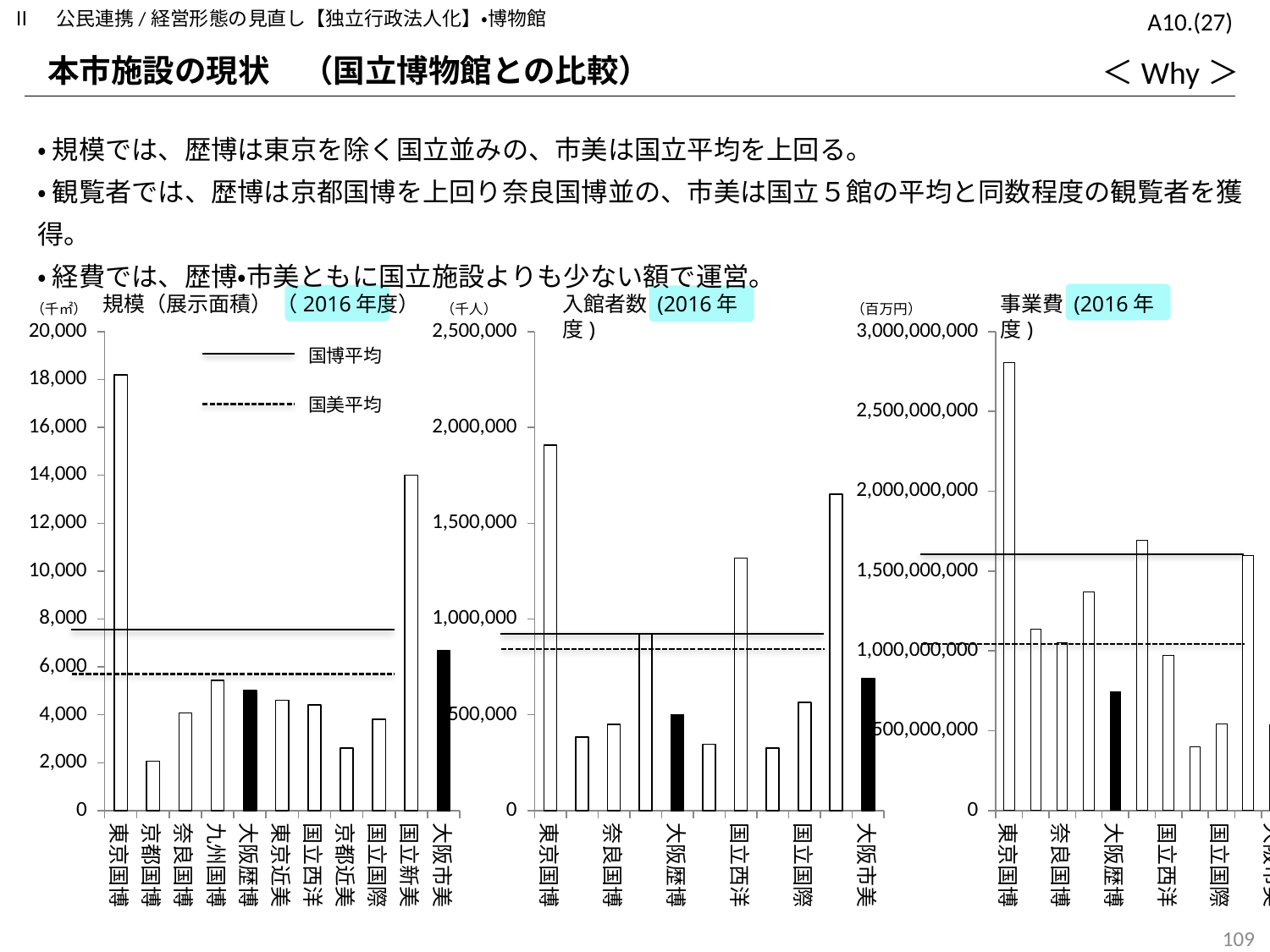
In the 規模（展示面積） chart, is the value for 京都国博 greater or less than 4,000? less In the 入館者数 chart, is the value for 大阪市美 greater or less than 1,000,000? less In the 規模（展示面積） chart, which category has the lowest value? 京都国博 In the 事業費 chart, which is larger, 東京国博 or 大阪歴博? 東京国博 In the 事業費 chart, is the value for 大阪歴博 greater or less than 500,000,000? greater In the 規模（展示面積） chart, which category has the highest value? 東京国博 In the 入館者数 chart, which category has the highest value? 東京国博 How many categories are shown on the x axis of the 規模（展示面積） chart? 11 What kind of chart is the 規模（展示面積） chart on the left? bar chart In the 規模（展示面積） chart, which is larger, 東京国博 or 国立新美? 東京国博 How many entries does the legend of the 規模（展示面積） chart list? 2